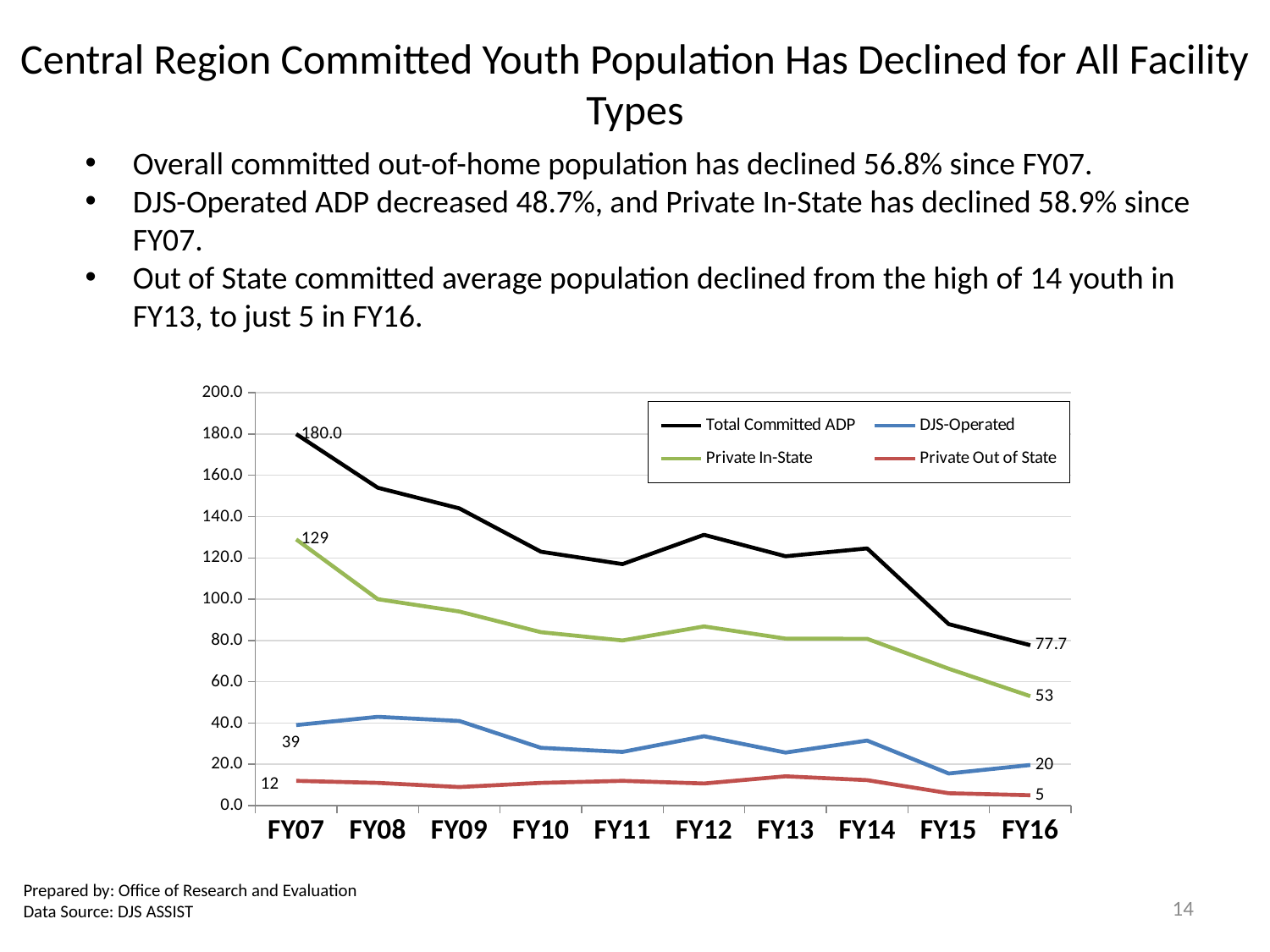
Is the Total Committed ADP value in FY10 greater or less than 140.0? less How many fiscal years are plotted along the x axis of the chart? 10 Which series has the lowest values across the chart? Private Out of State What is the Private Out of State value in FY16? 5 How many series does the chart legend list? 4 What is the Private In-State value in FY16? 53 What is the Total Committed ADP value in FY16? 77.7 What is the DJS-Operated value in FY07? 39 Does the Total Committed ADP line generally rise or fall from FY07 to FY16? fall By how much did the Private In-State value fall from FY07 to FY16? 76 What kind of chart is shown on the slide? line chart What is the Total Committed ADP value in FY07? 180.0